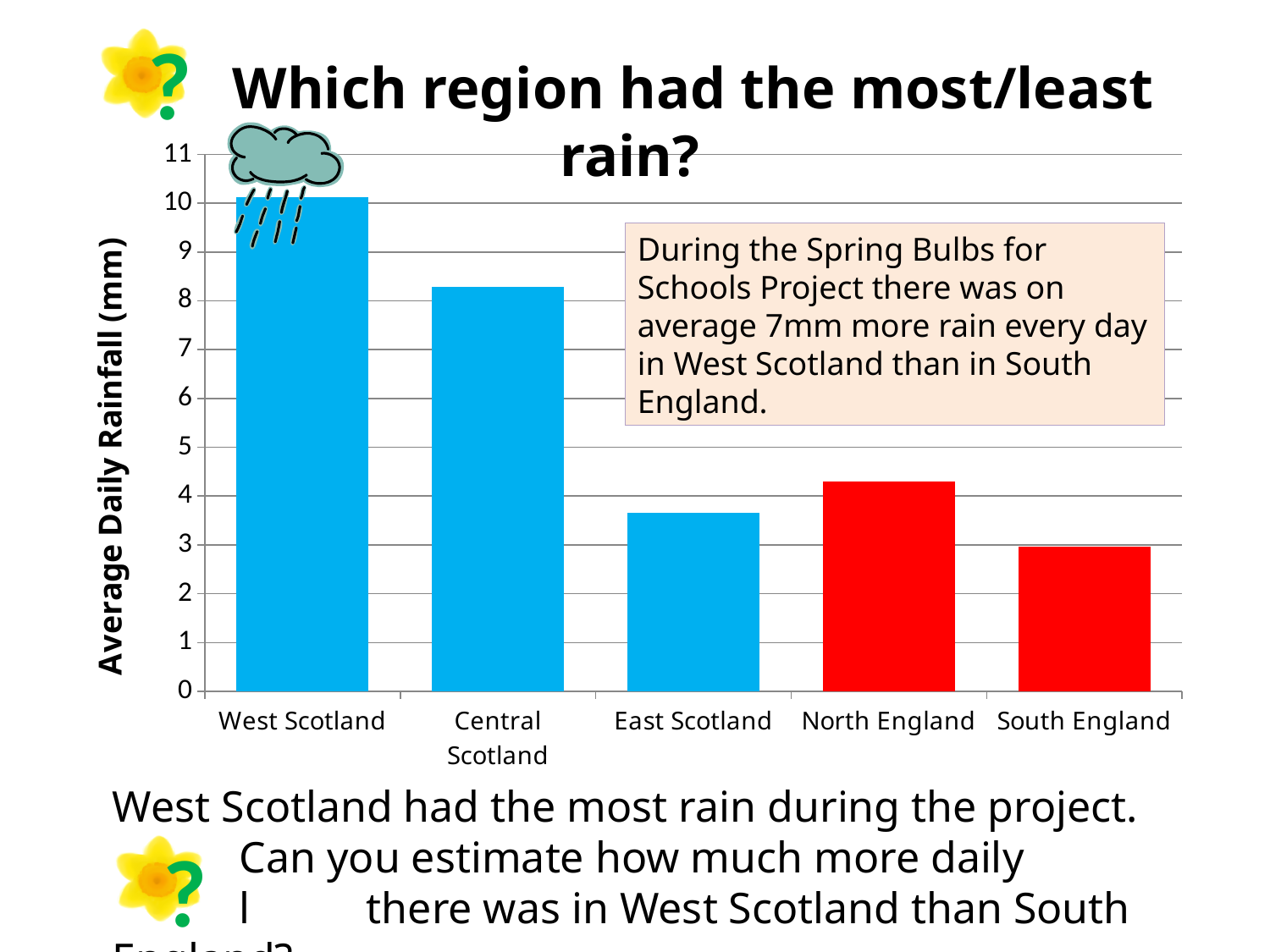
How many regions are shown on the chart? 5 Which region has the lowest average daily rainfall? South England What colour are the bars for the England regions? red What is the label on the vertical axis of the chart? Average Daily Rainfall (mm) Which has the higher average daily rainfall, Central Scotland or West Scotland? West Scotland Is the value for South England greater or less than 2? greater Which region has the highest average daily rainfall? West Scotland Which has the higher average daily rainfall, North England or East Scotland? North England Is the value for West Scotland greater or less than 9? greater Is the value for Central Scotland greater or less than 7? greater What kind of chart is shown on the slide? bar chart